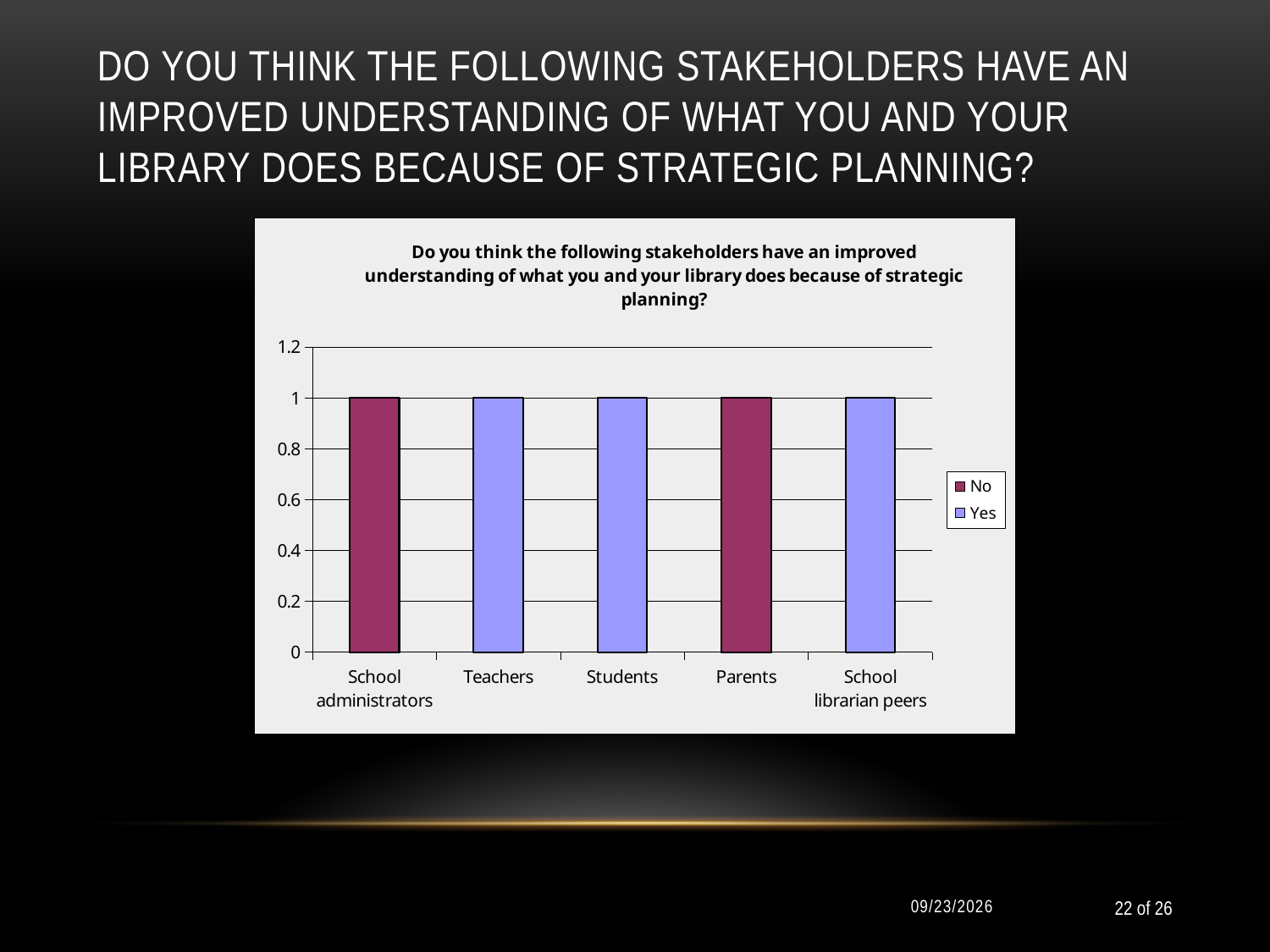
How many stakeholder categories are shown on the x axis of the chart? 5 What is the highest value shown on the y axis of the chart? 1.2 What kind of chart is shown on the slide? Bar chart What is the value of the bar for Teachers? 1 Is the value for Students greater or less than 0.8? greater What is the value of the bar for Parents? 1 How many series does the chart's legend list? 2 What is the value of the bar for School administrators? 1 What is the difference between the values for Teachers and Parents? 0 Which legend series does the bar for Students belong to? Yes Which legend series does the bar for Parents belong to? No Is the value for School librarian peers greater or less than 1.2? less